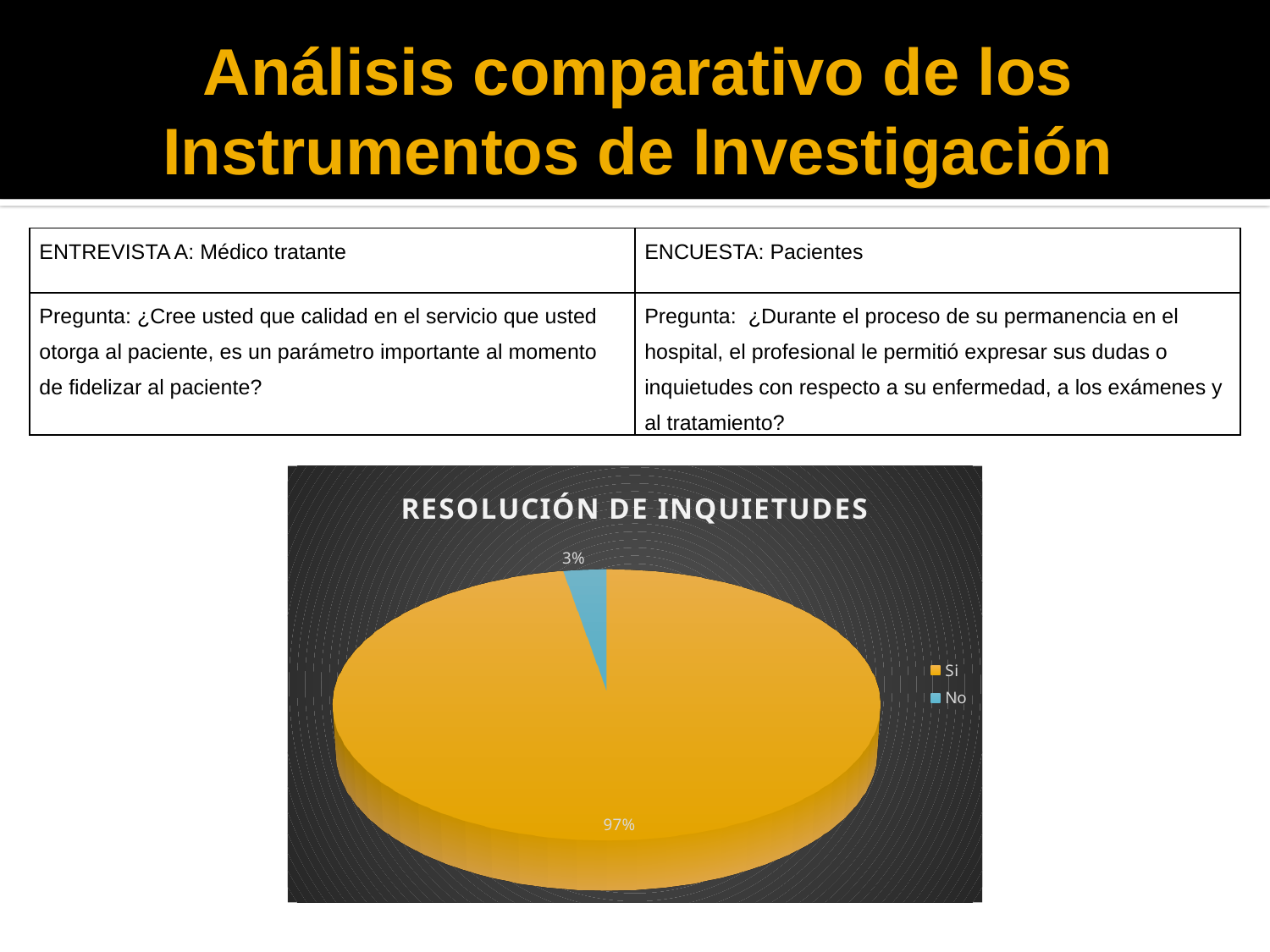
What is the difference in percentage points between the "Si" and "No" slices? 94 What is the title of the chart? RESOLUCIÓN DE INQUIETUDES What share of the pie does the "Si" slice represent? 97% Which category has the largest slice of the pie? Si How many categories does the legend list? 2 What kind of chart is shown on the slide? Pie chart How many slices does the pie chart have? 2 Which category has the smallest slice of the pie? No What colour is the "No" slice in the pie chart? Blue What share of the pie does the "No" slice represent? 3% Which is larger, the "Si" slice or the "No" slice? Si